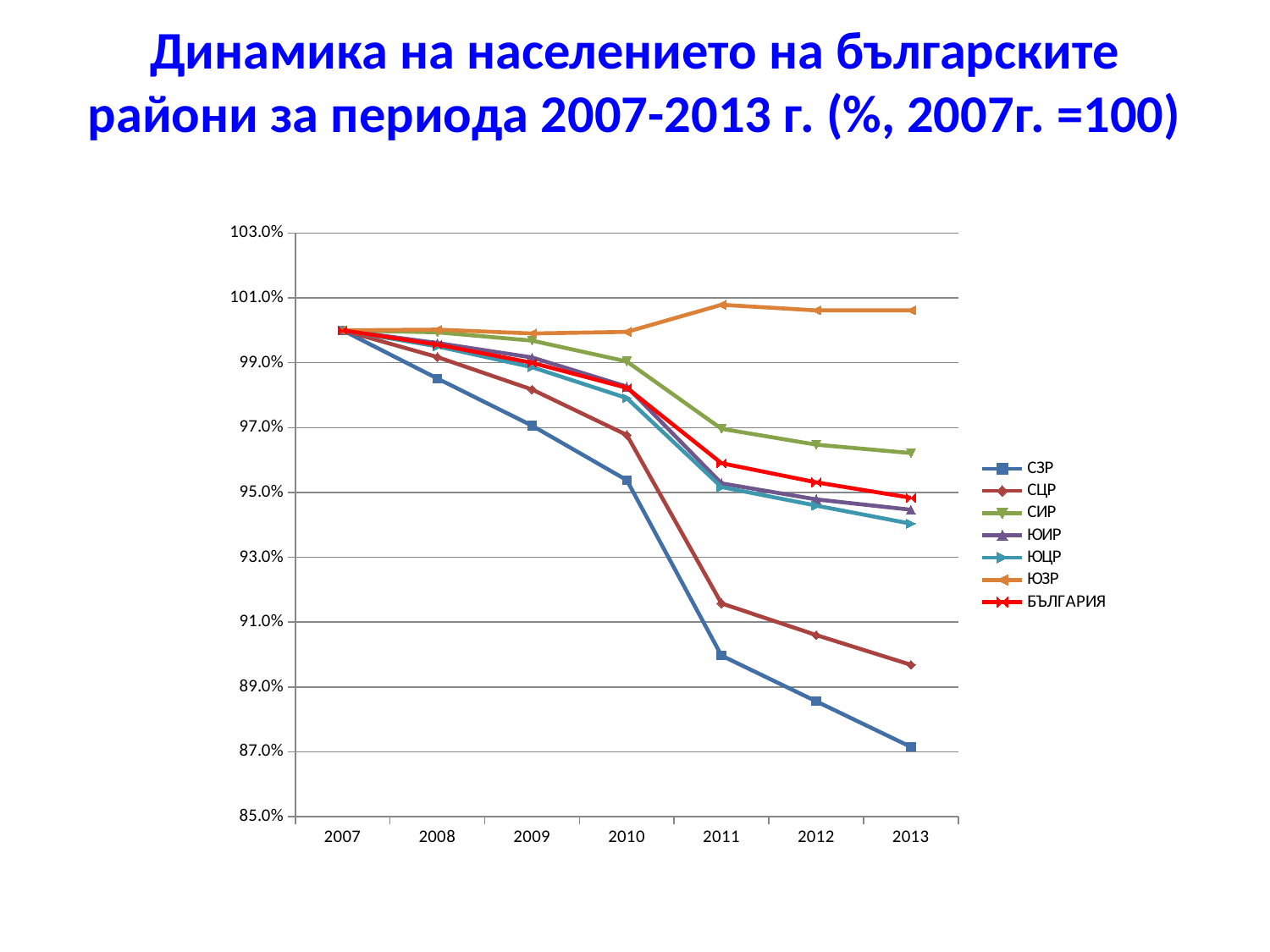
Is the value for ЮЗР in 2013 greater or less than 99.0%? greater How many series does the legend list? 7 Is the value for СИР in 2013 greater or less than 97.0%? less Which series has the highest value in 2013? ЮЗР Does the value for СЗР rise or fall from 2007 to 2013? fall What kind of chart is shown on the slide? line chart Which series is drawn in red on the chart? БЪЛГАРИЯ Is the value for СЗР in 2013 greater or less than 89.0%? less Which series has the lowest value in 2013? СЗР How many years are shown along the x axis? 7 Which is larger in 2013, the value for СЦР or the value for СЗР? СЦР